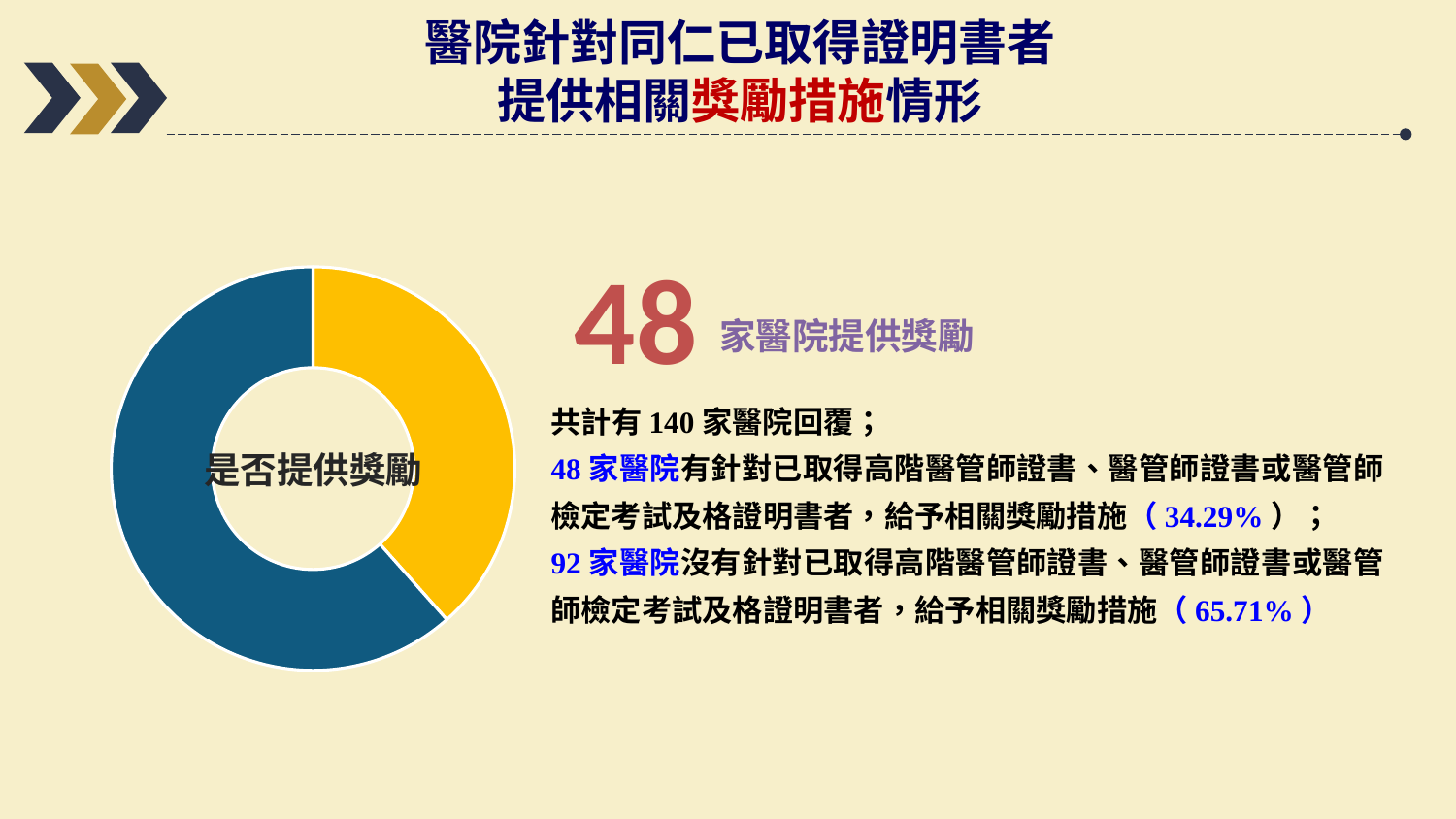
What is the difference between the number of hospitals not providing rewards and those providing rewards? 44 What colour is the slice representing hospitals that provide rewards (the smaller slice)? Yellow What share of hospitals do not provide rewards according to the slide? 65.71% Which slice of the donut chart is larger, the blue one or the yellow one? The blue one How many hospitals do not provide rewards to staff who obtained certificates? 92 What is the title shown in the centre of the donut chart? 是否提供獎勵 How many slices does the donut chart have? 2 How many hospitals provide rewards to staff who obtained certificates? 48 What share of hospitals provide rewards (獎勵) according to the slide? 34.29% Is the share of hospitals providing rewards greater or less than 50%? less How many hospitals responded in total? 140 What kind of chart is shown on the slide? Pie chart (donut)